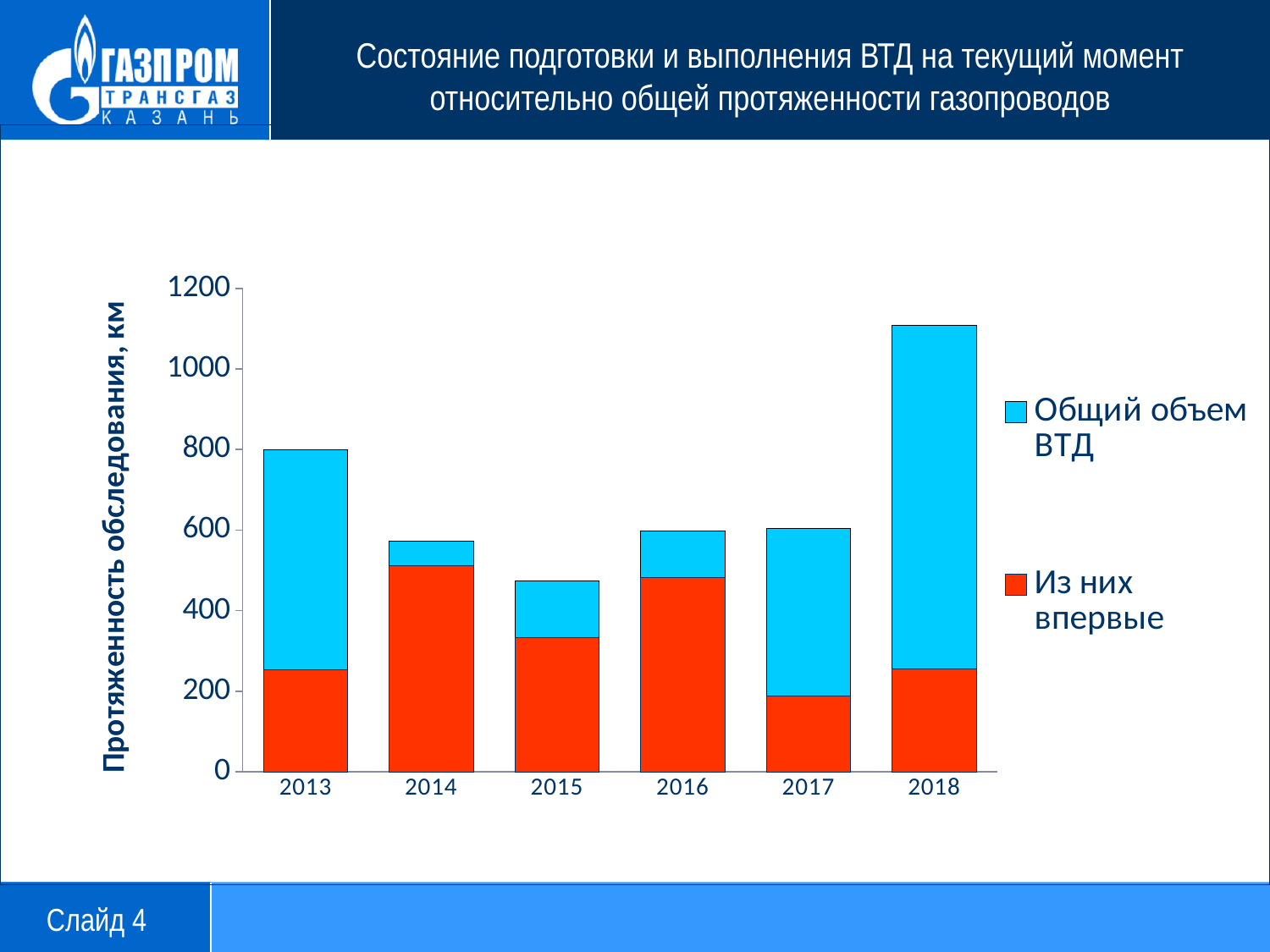
Which year has the shortest bar in the chart? 2015 How many years are shown on the x axis of the chart? 6 Which year has the tallest bar in the chart? 2018 Is the total bar height for 2018 greater or less than 1000? greater Is the total bar height for 2015 greater or less than 600? less Is the red "Из них впервые" value for 2014 greater or less than 400? greater Which year has the smallest red "Из них впервые" segment? 2017 What kind of chart is shown on the slide? bar chart What is the label of the vertical axis of the chart? Протяженность обследования, км Which year has the taller total bar, 2013 or 2014? 2013 How many series does the chart legend list? 2